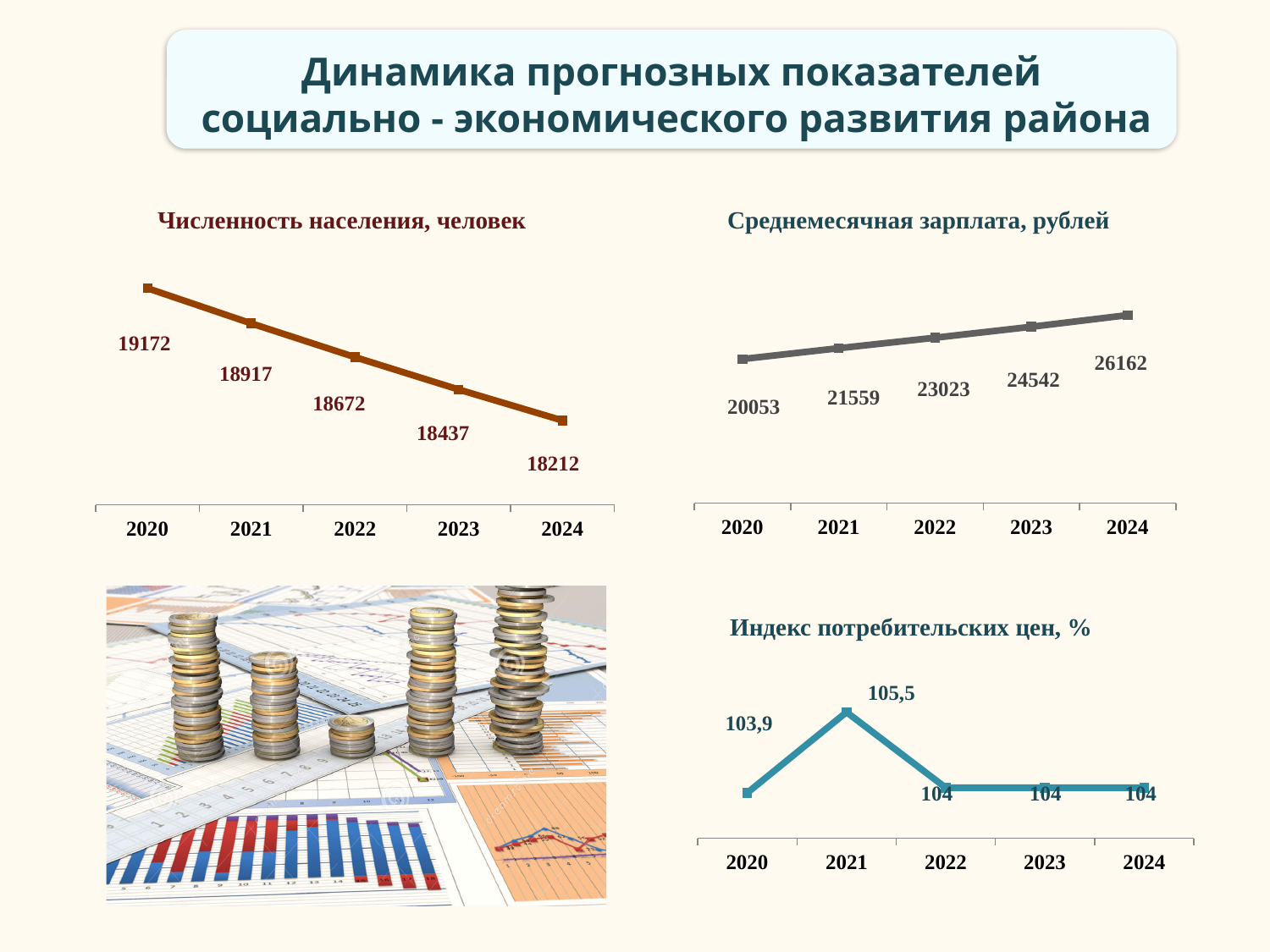
In the chart titled "Численность населения, человек", do the values rise or fall from 2020 to 2024? fall In the chart titled "Численность населения, человек", what is the difference between the 2020 and 2024 values? 960 In the chart titled "Индекс потребительских цен, %", which year has the highest value? 2021 In the chart titled "Индекс потребительских цен, %", what is the value for 2021? 105,5 In the chart titled "Численность населения, человек", what is the value for 2022? 18672 In the chart titled "Среднемесячная зарплата, рублей", what is the difference between the 2021 and 2020 values? 1506 In the chart titled "Среднемесячная зарплата, рублей", which year has the highest value? 2024 In the chart titled "Численность населения, человек", which year has the lowest value? 2024 In the chart titled "Индекс потребительских цен, %", which is larger, the value for 2020 or the value for 2022? 2022 What kind of chart is the one titled "Индекс потребительских цен, %"? line chart In the chart titled "Среднемесячная зарплата, рублей", what is the value for 2023? 24542 In the chart titled "Среднемесячная зарплата, рублей", how many years are plotted on the x axis? 5